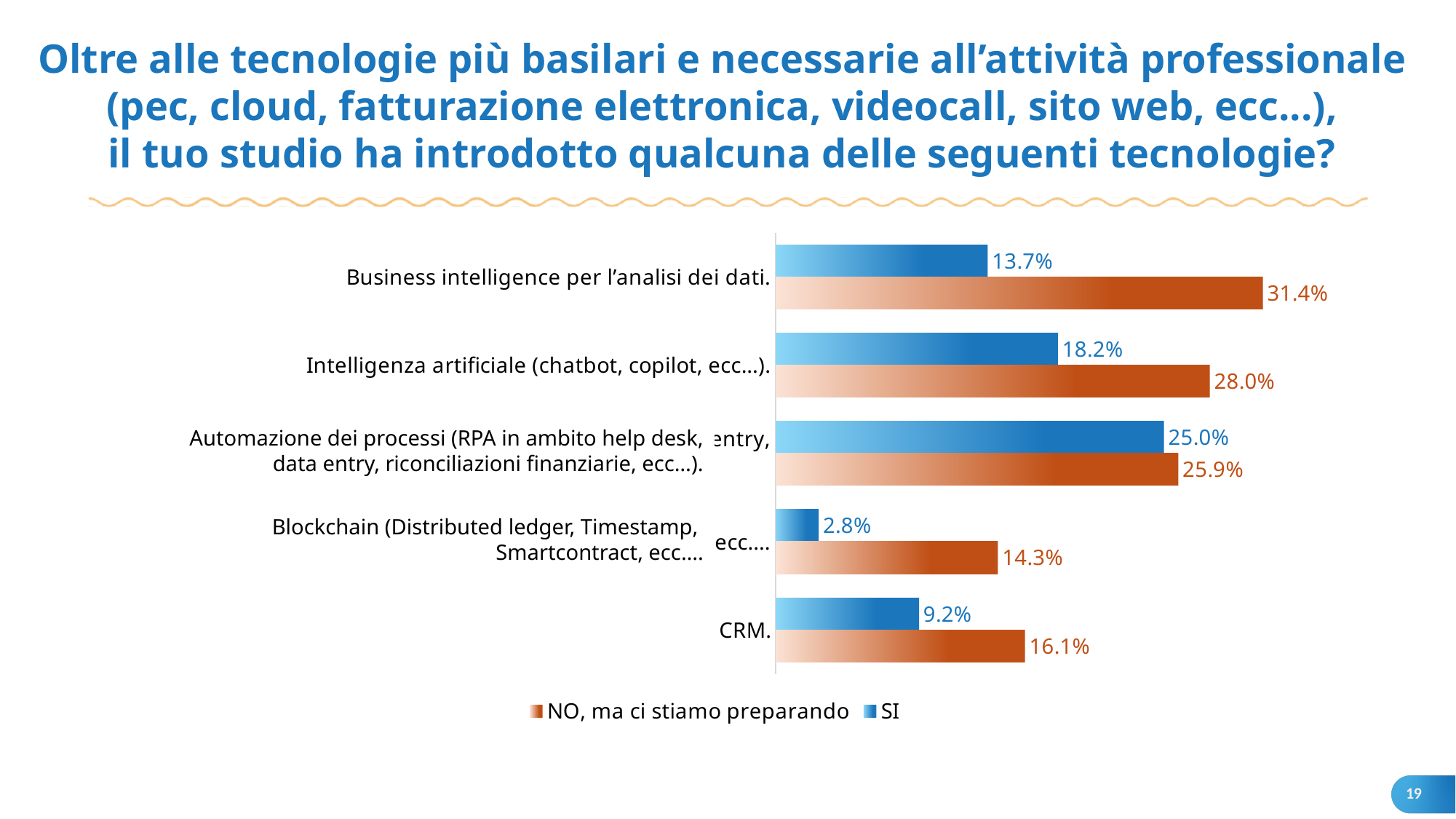
What is the "SI" value for Blockchain (Distributed ledger, Timestamp, Smartcontract, ecc....)? 2.8% What is the "SI" value for Business intelligence per l'analisi dei dati? 13.7% What is the "NO, ma ci stiamo preparando" value for Intelligenza artificiale (chatbot, copilot, ecc...)? 28.0% What is the "NO, ma ci stiamo preparando" value for CRM? 16.1% Which colour represents the "SI" series in the chart? Blue How many series does the legend list? 2 What kind of chart is shown on the slide? Bar chart Which is larger for CRM: the "SI" value or the "NO, ma ci stiamo preparando" value? NO, ma ci stiamo preparando Which category has the highest "SI" value? Automazione dei processi (RPA in ambito help desk, data entry, riconciliazioni finanziarie, ecc...) Which category has the lowest "NO, ma ci stiamo preparando" value? Blockchain (Distributed ledger, Timestamp, Smartcontract, ecc....) What is the difference between the "NO, ma ci stiamo preparando" and "SI" values for Business intelligence per l'analisi dei dati? 17.7% How many categories are shown in the chart? 5